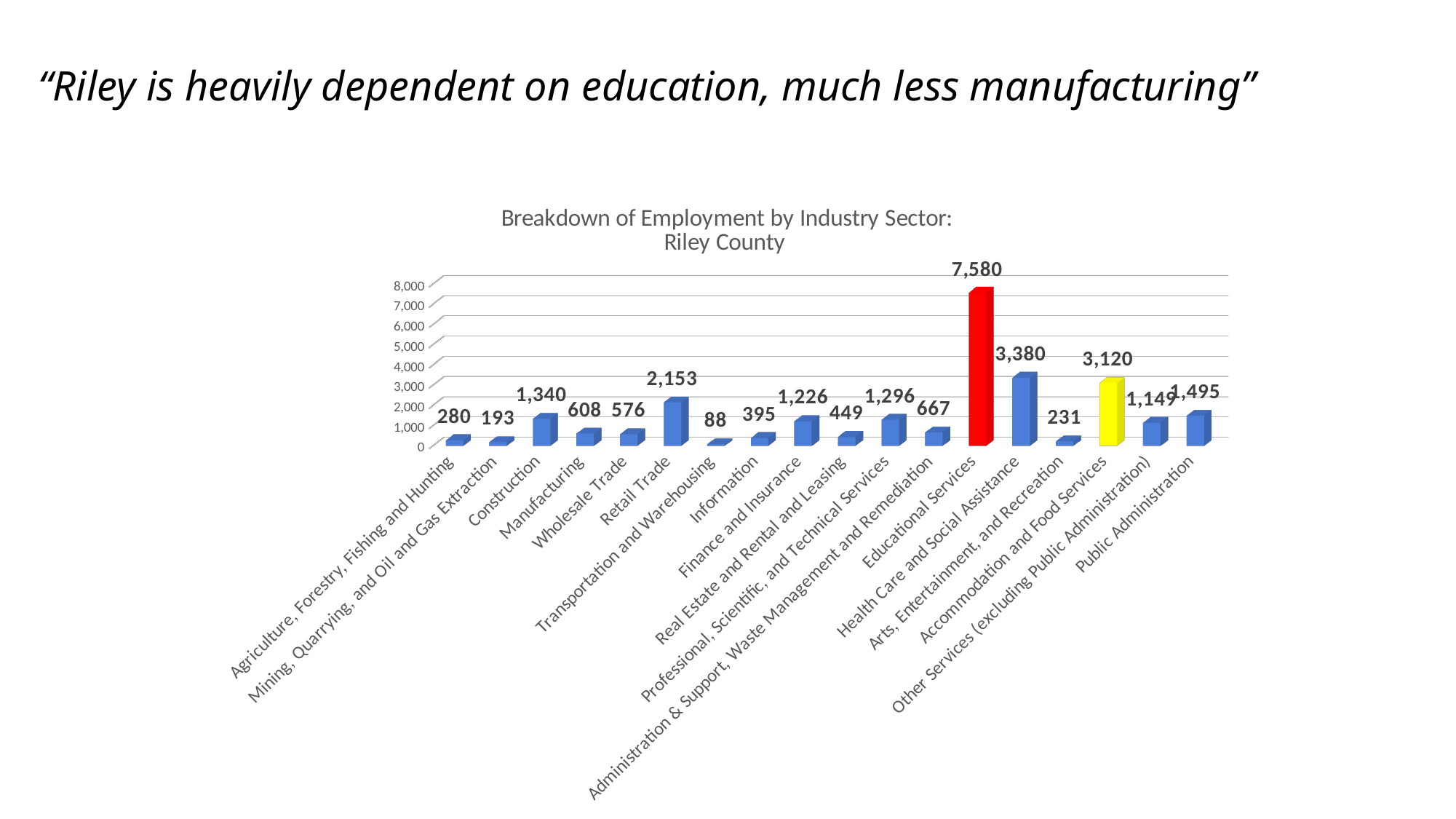
What is the value for Manufacturing? 608 How many industry sectors are shown on the chart? 18 What kind of chart is this? Bar chart What is the difference between Educational Services and Manufacturing? 6,972 Which industry sector has the highest employment? Educational Services Which industry sector has the lowest employment? Transportation and Warehousing Which is larger, Construction or Finance and Insurance? Construction What is the value for Accommodation and Food Services? 3,120 What is the value for Educational Services? 7,580 What is the value for Retail Trade? 2,153 Which bar is coloured red? Educational Services What is the difference between Health Care and Social Assistance and Accommodation and Food Services? 260